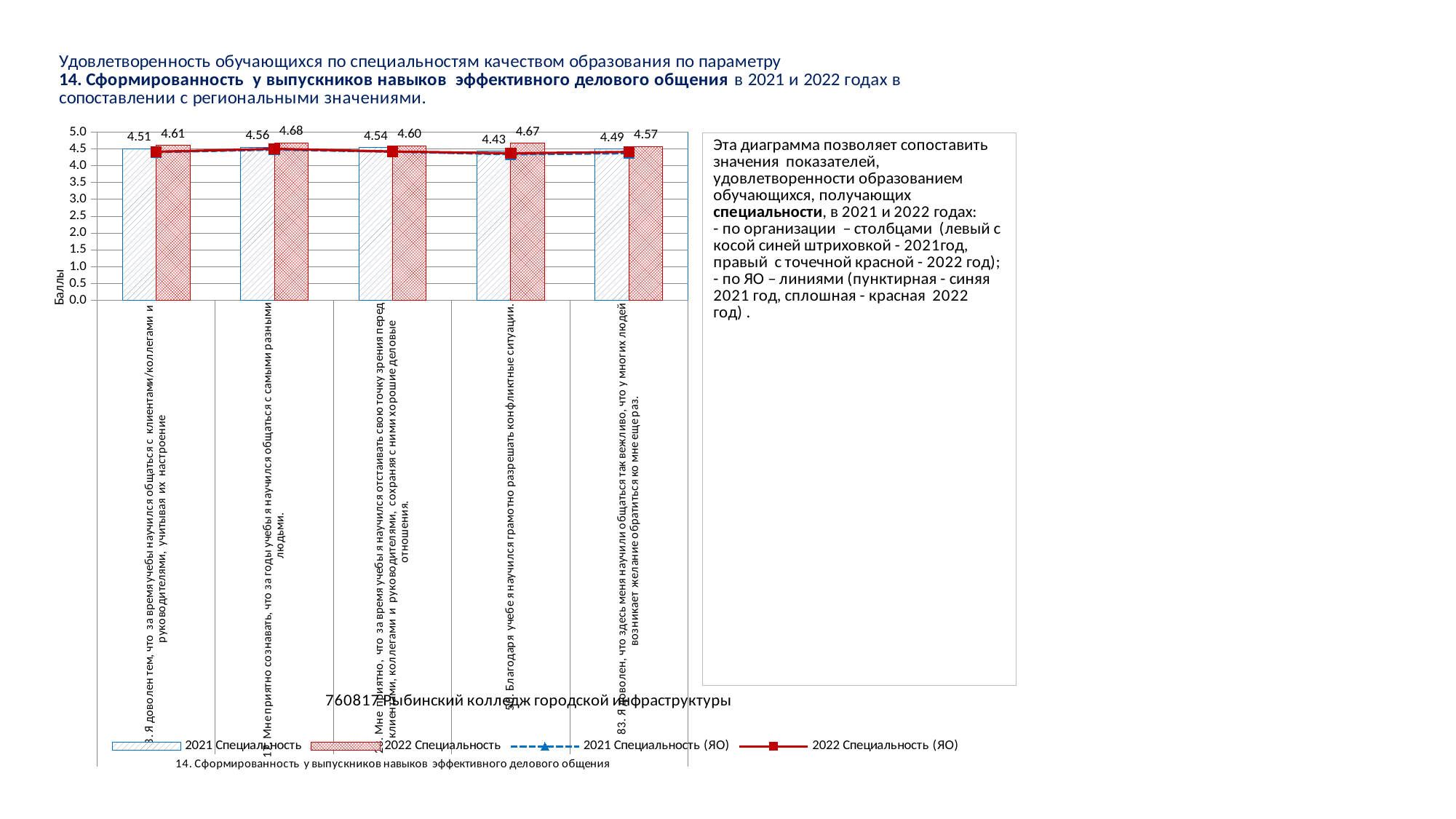
What is the value of the 2022 Специальность bar for the category "Благодаря учебе я научился грамотно разрешать конфликтные ситуации"? 4.67 Is the 2022 Специальность (ЯО) line value for the first category greater or less than 4.0? greater Which category has the highest 2022 Специальность bar value? Мне приятно сознавать, что за годы учебы я научился общаться с самыми разными людьми (4.68) What is the difference between the 2022 and 2021 Специальность bar values for the category "Благодаря учебе я научился грамотно разрешать конфликтные ситуации"? 0.24 What is the title of the vertical axis of the chart? Баллы Which category has the lowest 2021 Специальность bar value? Благодаря учебе я научился грамотно разрешать конфликтные ситуации (4.43) For the third category ("...научился отстаивать свою точку зрения..."), which is larger: the 2021 Специальность bar or the 2022 Специальность bar? 2022 Специальность (4.60) What kind of chart is shown on the slide? A bar chart combined with line series What is the value of the 2022 Специальность bar for the last category ("83. Я доволен, что здесь меня научили общаться так вежливо...")? 4.57 How many categories are shown on the x axis of the chart? 5 What is the value of the 2021 Специальность bar for the first category ("3. Я доволен тем, что за время учебы научился общаться с клиентами/коллегами и руководителями...")? 4.51 How many series does the chart legend list? 4